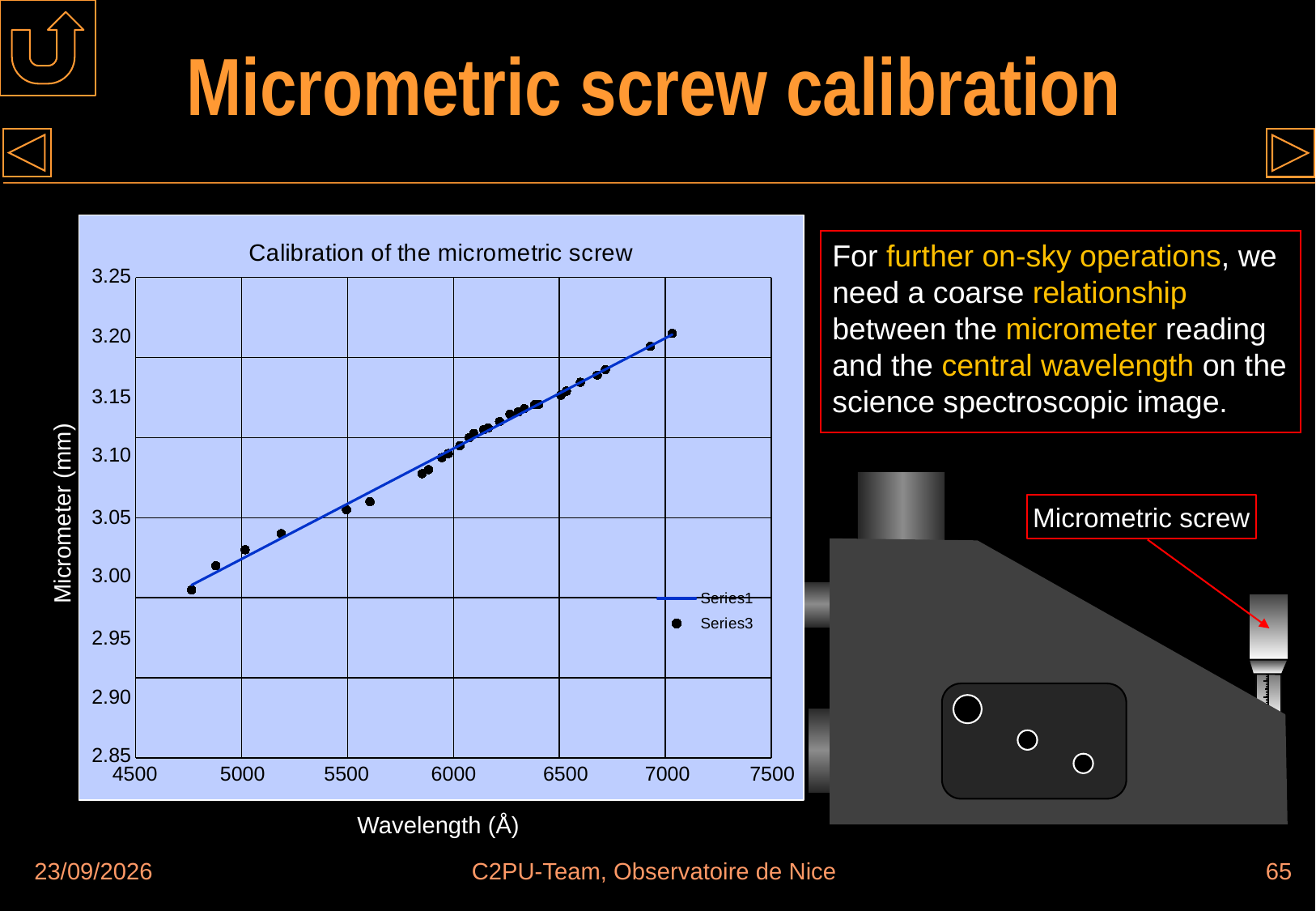
Is the micrometer value of the data points near 6000 Å greater or less than 3.05? greater Does the micrometer reading rise or fall as the wavelength increases? Rises Which data point has the higher micrometer value: the one near 5000 Å or the one near 6500 Å? The one near 6500 Å What is the highest wavelength tick shown on the x axis? 7500 Is the micrometer value of the data point at the highest wavelength (around 7000 Å) greater or less than 3.15? greater What is the label of the x axis of the chart? Wavelength (Å) Is the micrometer value of the data point at the lowest wavelength (around 4750 Å) greater or less than 3.05? less How many series does the chart legend list? 2 What is the title of the chart? Calibration of the micrometric screw What kind of chart is shown on the slide? Scatter plot with a trend line